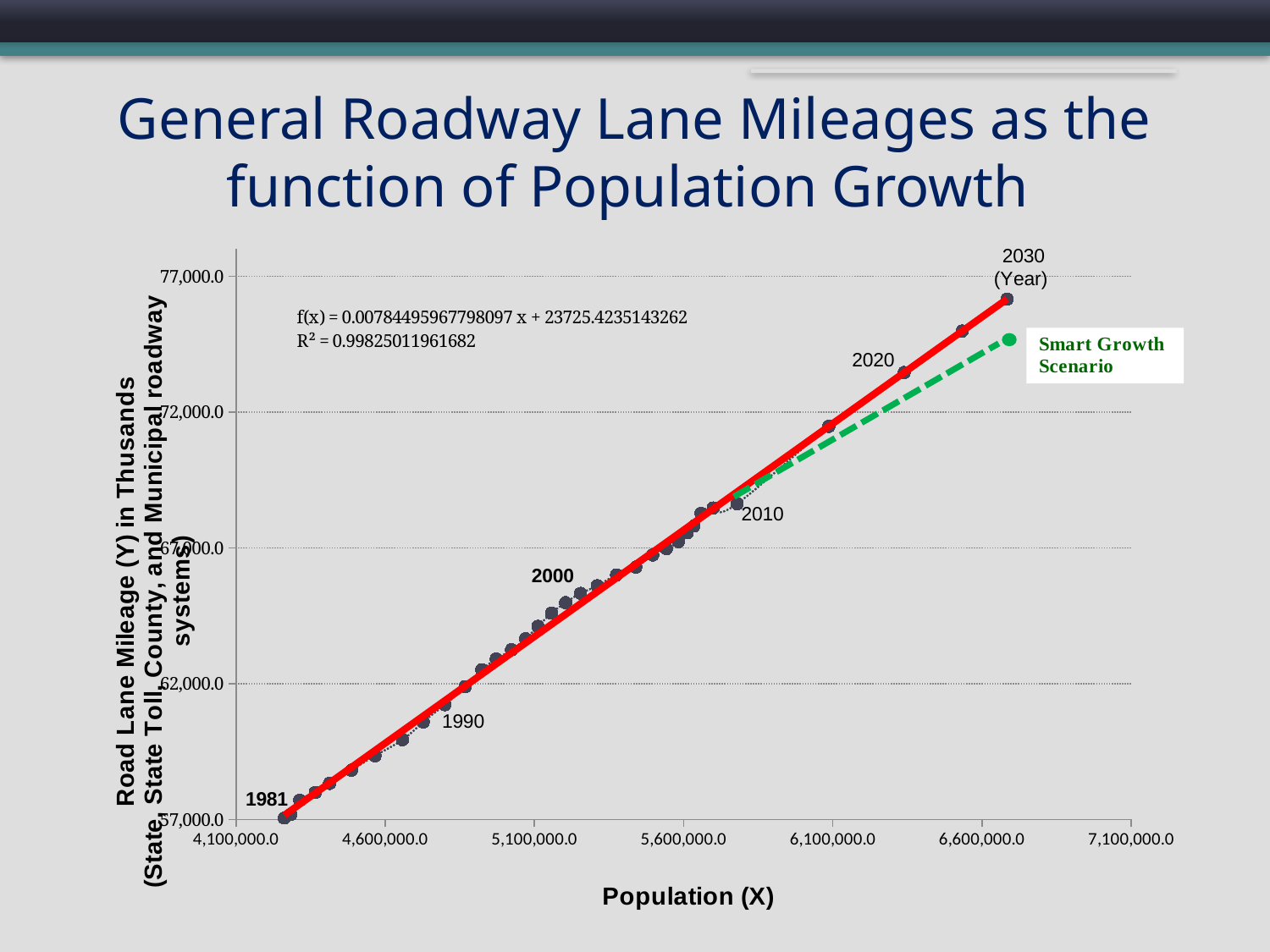
Which labeled year has the lowest road lane mileage on the chart? 1981 What kind of chart is shown on the slide? scatter chart Is the road lane mileage value for the 2010 point greater or less than 67,000.0? greater How many year labels are printed on the chart? 6 Is the road lane mileage value for the 2000 point greater or less than 67,000.0? less Is the road lane mileage value for the 2030 point on the red trend line greater or less than 72,000.0? greater Which has the higher road lane mileage in 2030: the red trend line endpoint or the Smart Growth Scenario endpoint? the red trend line endpoint Does road lane mileage rise or fall as population increases along the x axis? rise What is the R² value printed on the chart? 0.99825011961682 What is the label of the x axis? Population (X)